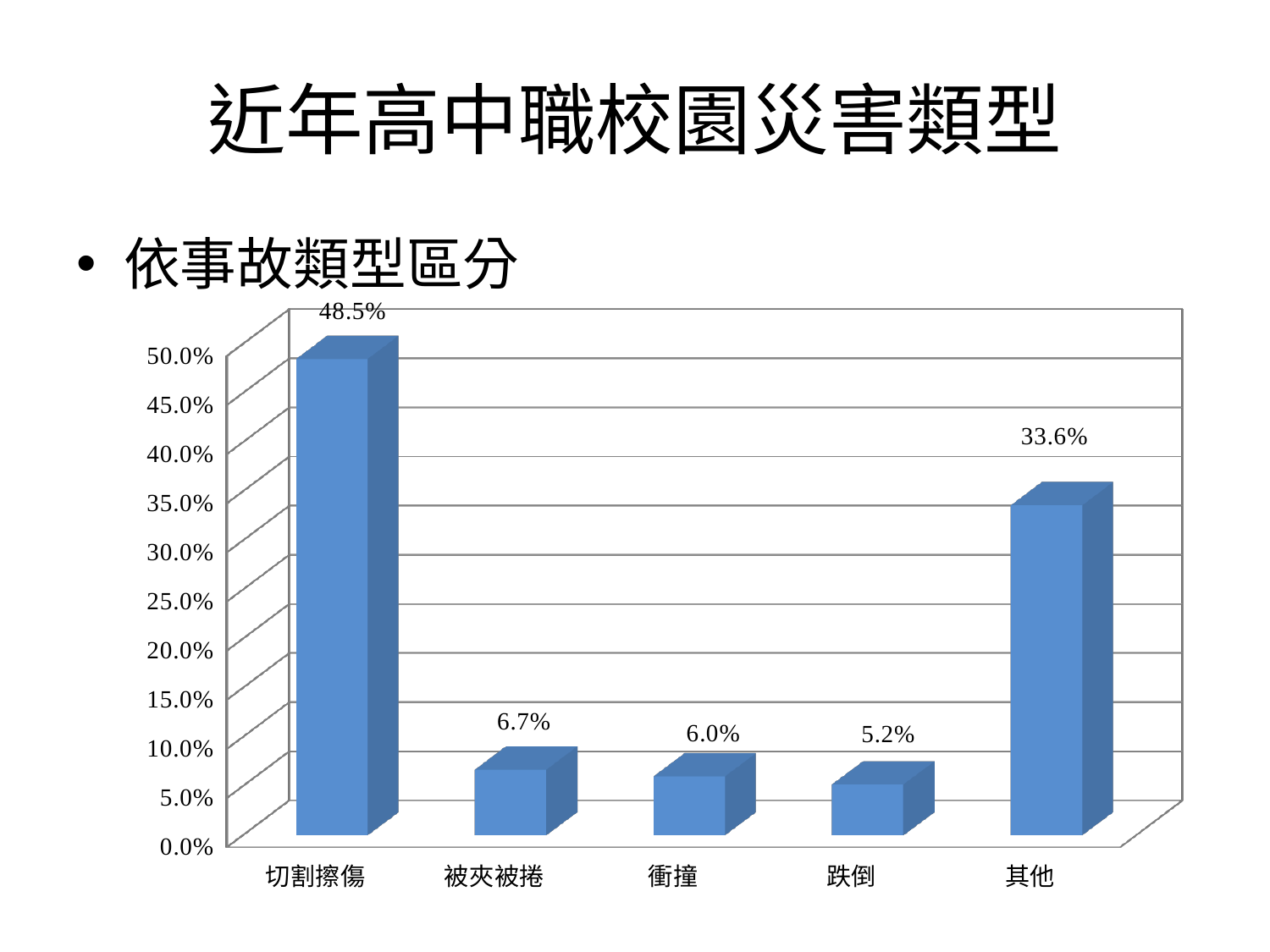
Which category has the highest value? 切割擦傷 Which is larger, the value for 衝撞 or the value for 跌倒? 衝撞 What kind of chart is shown on the slide? bar chart Which category has the lowest value? 跌倒 What is the difference between the values for 被夾被捲 and 衝撞? 0.7% What is the value for 其他? 33.6% What is the value for 被夾被捲? 6.7% What is the value for 切割擦傷? 48.5% What is the difference between the values for 切割擦傷 and 其他? 14.9% Is the value for 其他 greater or less than 30.0%? greater What is the value for 跌倒? 5.2% How many categories are shown on the x axis? 5